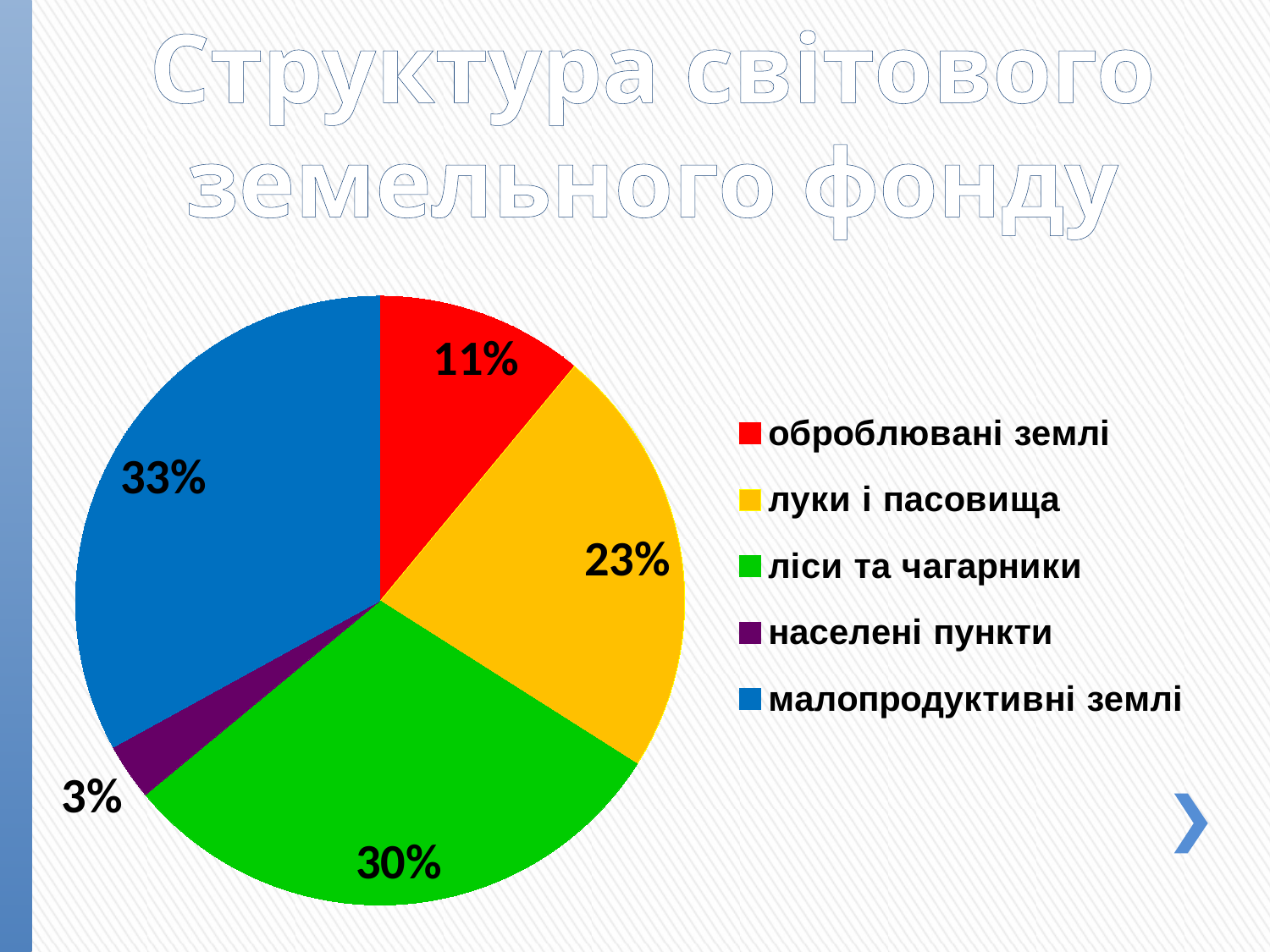
What share of the pie is labelled for ліси та чагарники? 30% Which is larger, the slice for луки і пасовища or the slice for ліси та чагарники? ліси та чагарники Which category has the smallest slice of the pie? населені пункти What share of the pie is labelled for малопродуктивні землі? 33% What is the difference in percentage points between малопродуктивні землі and оброблювані землі? 22 What share of the pie is labelled for оброблювані землі? 11% Which category has the largest slice of the pie? малопродуктивні землі What kind of chart is shown on the slide? pie chart What colour is the slice for населені пункти? purple How many categories does the legend list? 5